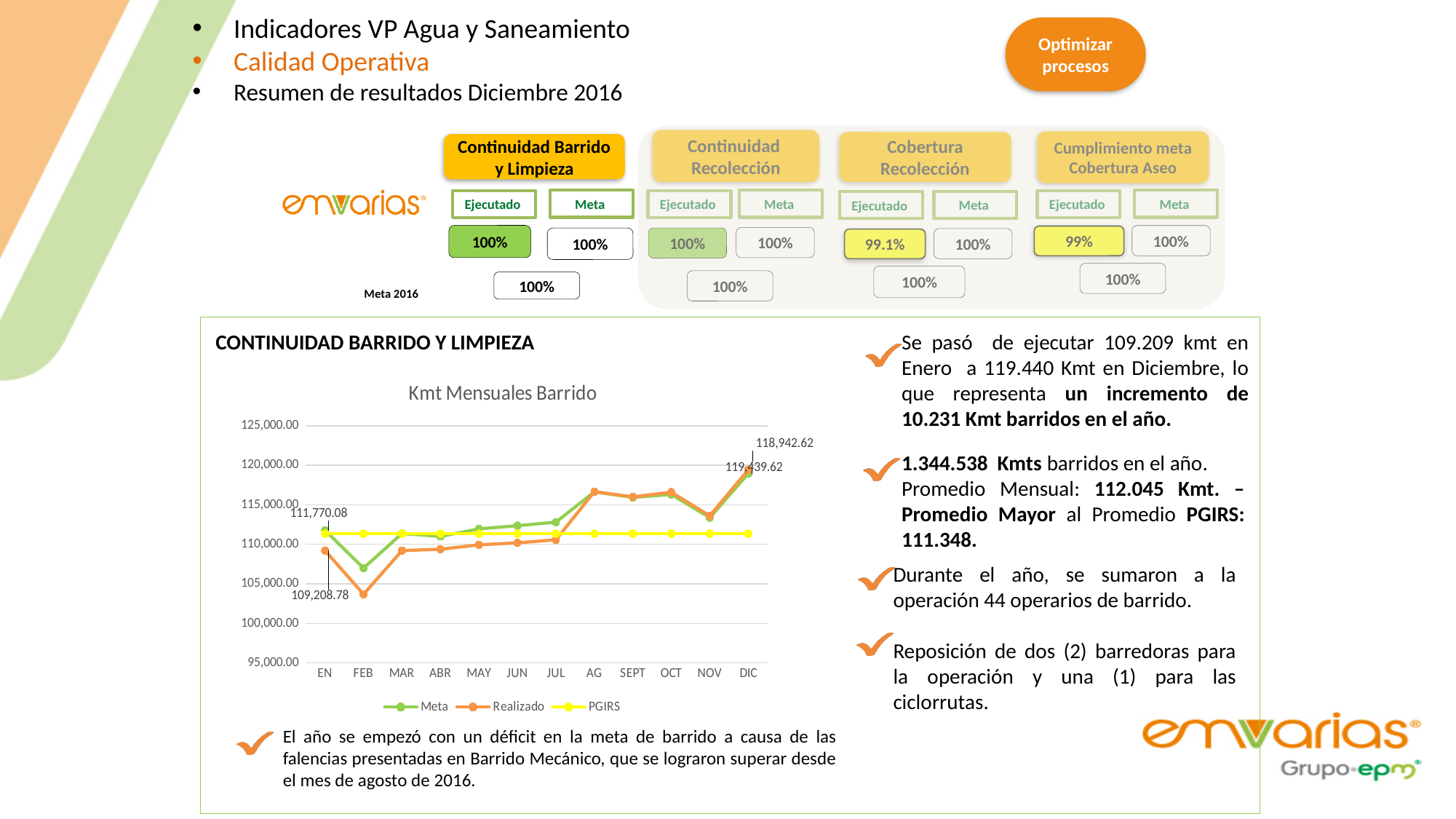
What is the Meta value for DIC in the "Kmt Mensuales Barrido" chart? 118,942.62 How many series does the legend of the "Kmt Mensuales Barrido" chart list? 3 In the "Kmt Mensuales Barrido" chart, which month has the lowest Realizado value? FEB What is the title of the line chart on the slide? Kmt Mensuales Barrido In the "Kmt Mensuales Barrido" chart, what is the difference between the Realizado value in DIC and the Realizado value in EN? 10,230.84 What kind of chart is "Kmt Mensuales Barrido"? line chart In the "Kmt Mensuales Barrido" chart, is the Realizado value for FEB greater or less than 105,000.00? less How many months are shown on the x axis of the "Kmt Mensuales Barrido" chart? 12 What is the Realizado value for EN in the "Kmt Mensuales Barrido" chart? 109,208.78 What is the Meta value for EN in the "Kmt Mensuales Barrido" chart? 111,770.08 What is the Realizado value for DIC in the "Kmt Mensuales Barrido" chart? 119,439.62 In the "Kmt Mensuales Barrido" chart, which is larger in DIC: Meta or Realizado? Realizado